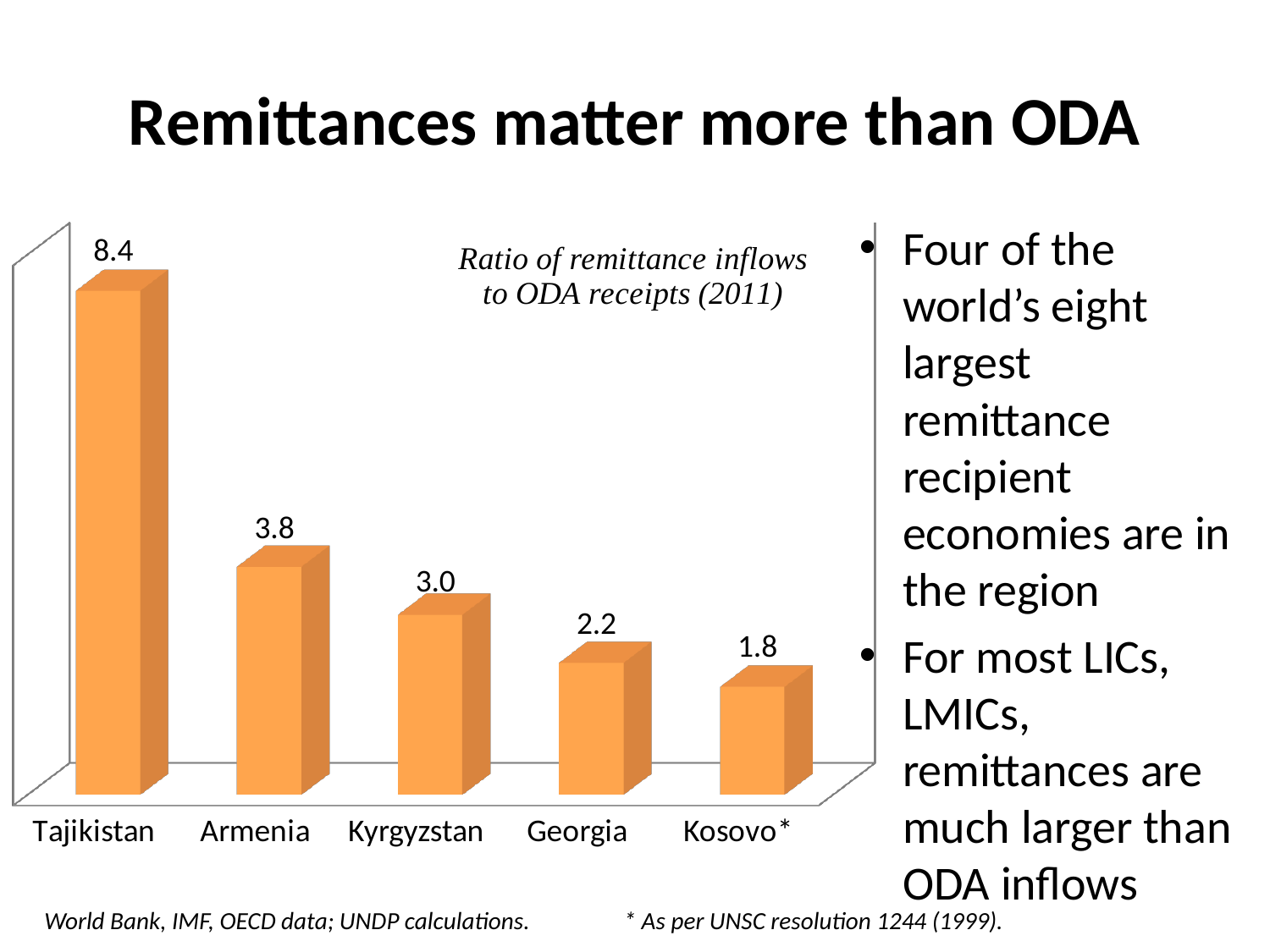
How many countries are shown in the chart? 5 What is the value shown for Kyrgyzstan? 3.0 What is the value shown for Georgia? 2.2 What is the value shown for Armenia? 3.8 What kind of chart is shown on the slide? Bar chart What is the ratio of remittance inflows to ODA receipts for Tajikistan? 8.4 What is the difference between the values for Tajikistan and Armenia? 4.6 What is the difference between the values for Kyrgyzstan and Georgia? 0.8 Which country has the highest ratio of remittance inflows to ODA receipts? Tajikistan Do the values rise or fall from left to right across the x axis? Fall Which has a larger value, Armenia or Georgia? Armenia Which category has the lowest value in the chart? Kosovo*